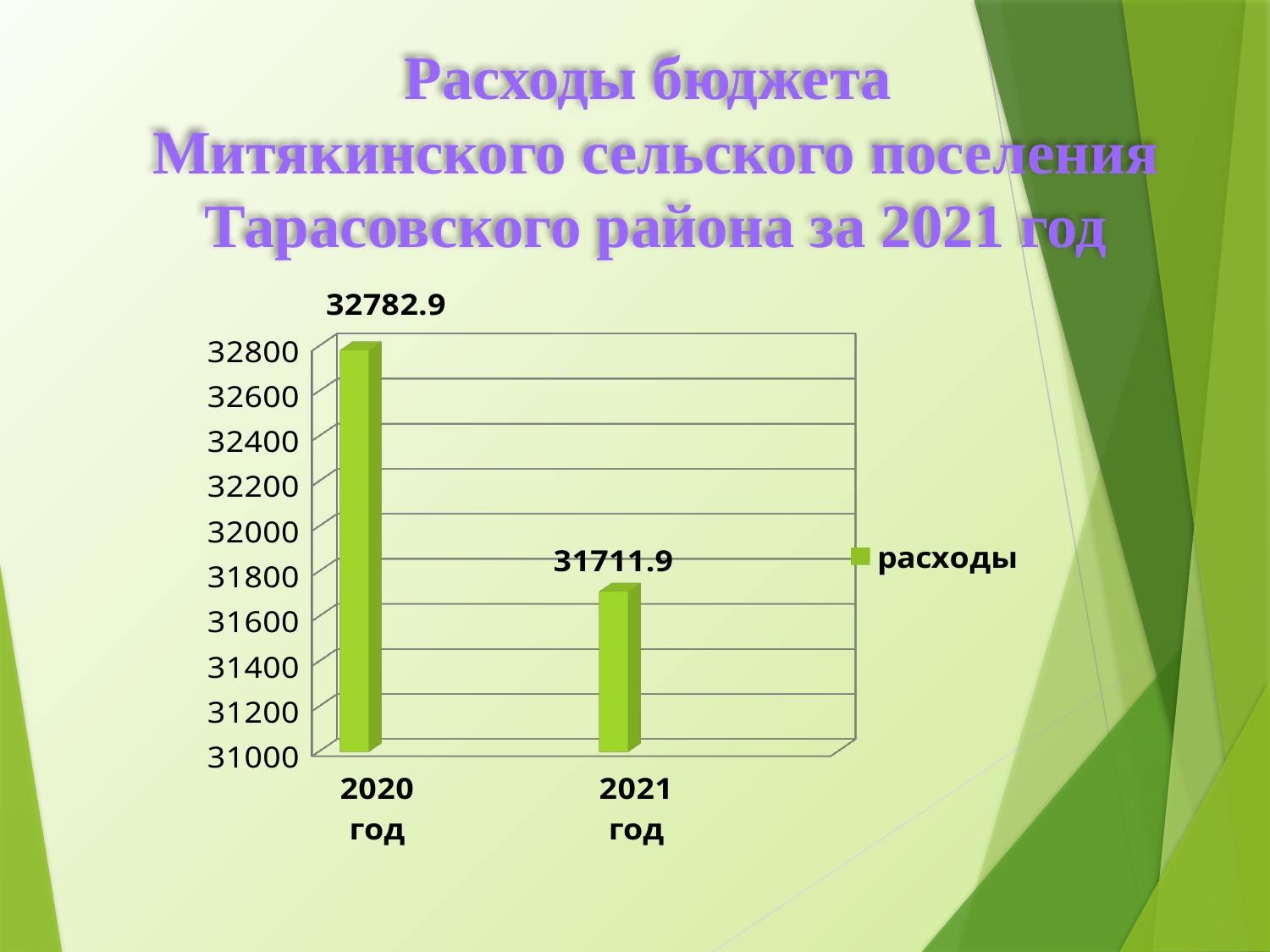
Which is larger, the value for 2020 год or for 2021 год? 2020 год What is the name of the series in the legend? расходы What is the value for 2020 год? 32782.9 Is the value for 2021 год greater or less than 32000? less Is the value for 2020 год greater or less than 32600? greater What kind of chart is shown? bar chart How many categories are shown on the x axis? 2 Which year has the highest value? 2020 год What is the value for 2021 год? 31711.9 How many series does the legend list? 1 What is the difference between the values for 2020 год and 2021 год? 1071 Which year has the lowest value? 2021 год